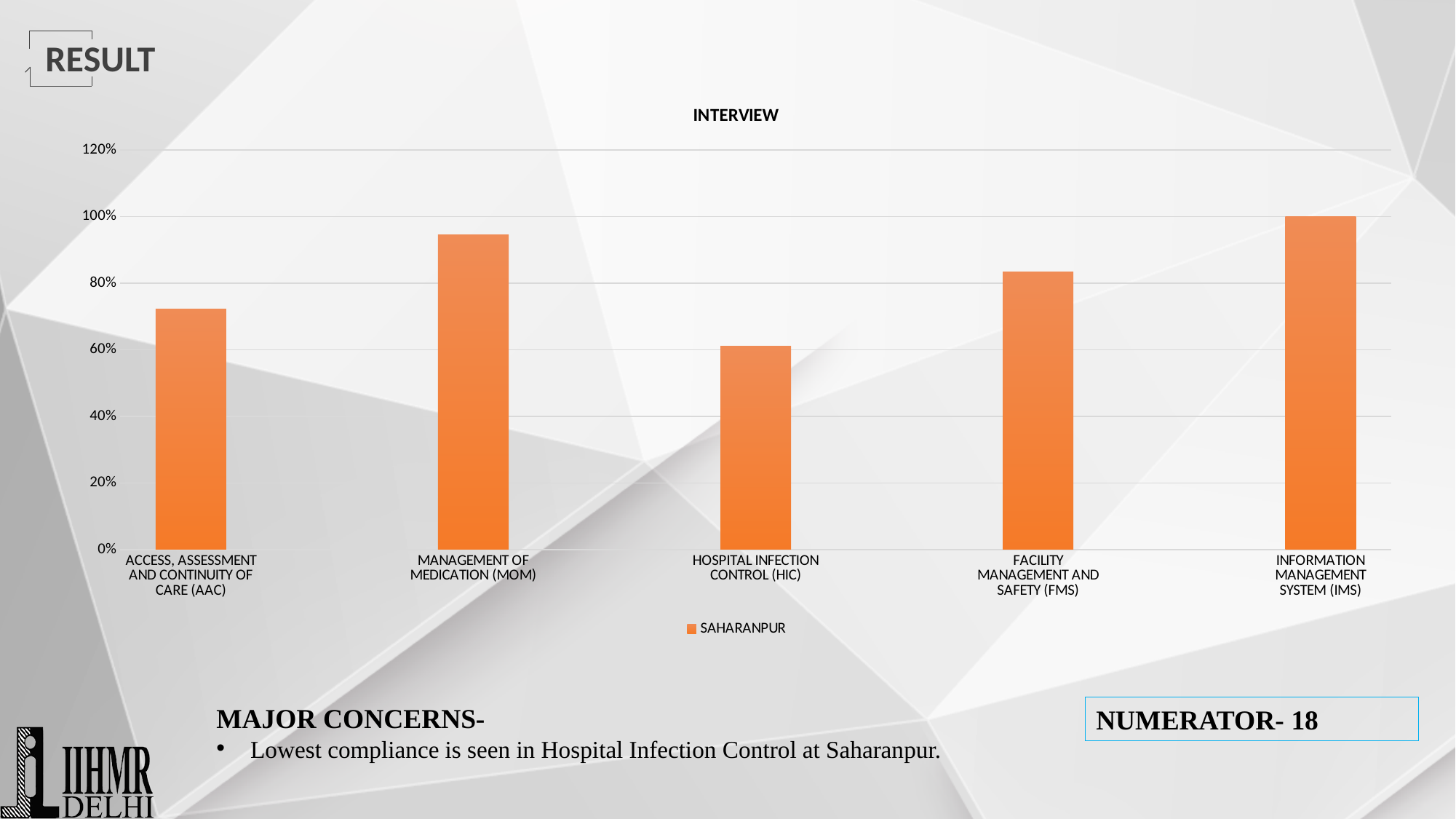
Is the value for HOSPITAL INFECTION CONTROL (HIC) greater or less than 80%? less What series name is shown in the chart legend? SAHARANPUR What is the title of the chart? INTERVIEW Is the value for ACCESS, ASSESSMENT AND CONTINUITY OF CARE (AAC) greater or less than 80%? less Which is larger, the value for FACILITY MANAGEMENT AND SAFETY (FMS) or the value for HOSPITAL INFECTION CONTROL (HIC)? FACILITY MANAGEMENT AND SAFETY (FMS) Is the value for MANAGEMENT OF MEDICATION (MOM) greater or less than 80%? greater Which is larger, the value for MANAGEMENT OF MEDICATION (MOM) or the value for ACCESS, ASSESSMENT AND CONTINUITY OF CARE (AAC)? MANAGEMENT OF MEDICATION (MOM) Which category has the highest value? INFORMATION MANAGEMENT SYSTEM (IMS) How many categories are plotted on the chart? 5 How many series does the chart legend list? 1 What kind of chart is shown on the slide? bar chart Which category has the lowest value? HOSPITAL INFECTION CONTROL (HIC)